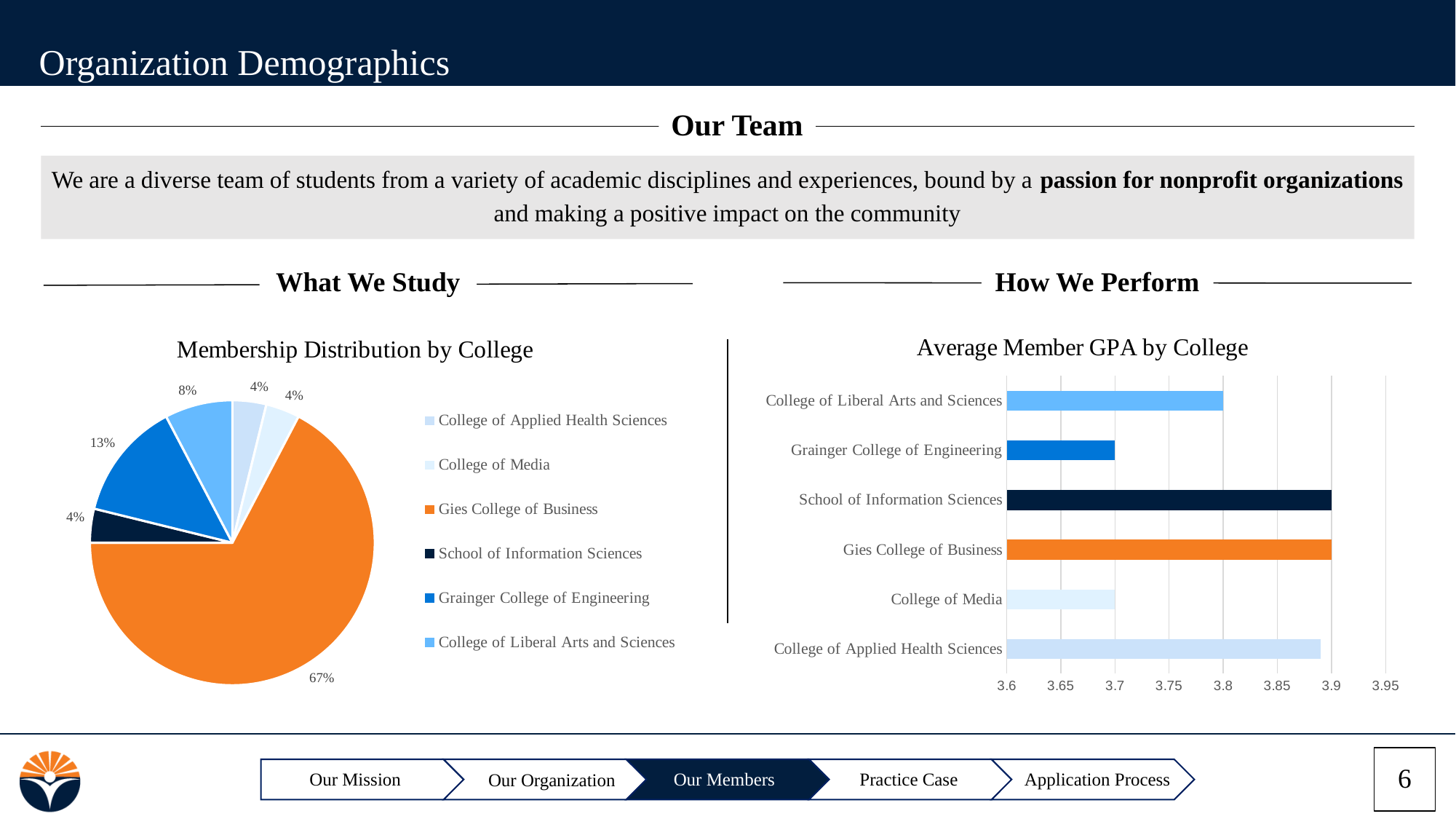
In the Average Member GPA by College chart, what is the average GPA for Grainger College of Engineering? 3.7 How many colleges are listed in the legend of the Membership Distribution by College chart? 6 In the Average Member GPA by College chart, what is the average GPA for the College of Liberal Arts and Sciences? 3.8 In the Membership Distribution by College pie chart, what share of members belong to Grainger College of Engineering? 13% How many colleges are shown in the Average Member GPA by College chart? 6 In the Average Member GPA by College chart, is the value for the College of Applied Health Sciences greater or less than 3.85? greater What kind of chart is the Average Member GPA by College chart? Bar chart In the Membership Distribution by College chart, which college has the largest slice? Gies College of Business In the Membership Distribution by College pie chart, what share of members belong to Gies College of Business? 67% What kind of chart is the Membership Distribution by College chart? Pie chart In the Average Member GPA by College chart, which has the higher average GPA: Grainger College of Engineering or the College of Liberal Arts and Sciences? College of Liberal Arts and Sciences In the Membership Distribution by College pie chart, what share of members belong to the College of Liberal Arts and Sciences? 8%